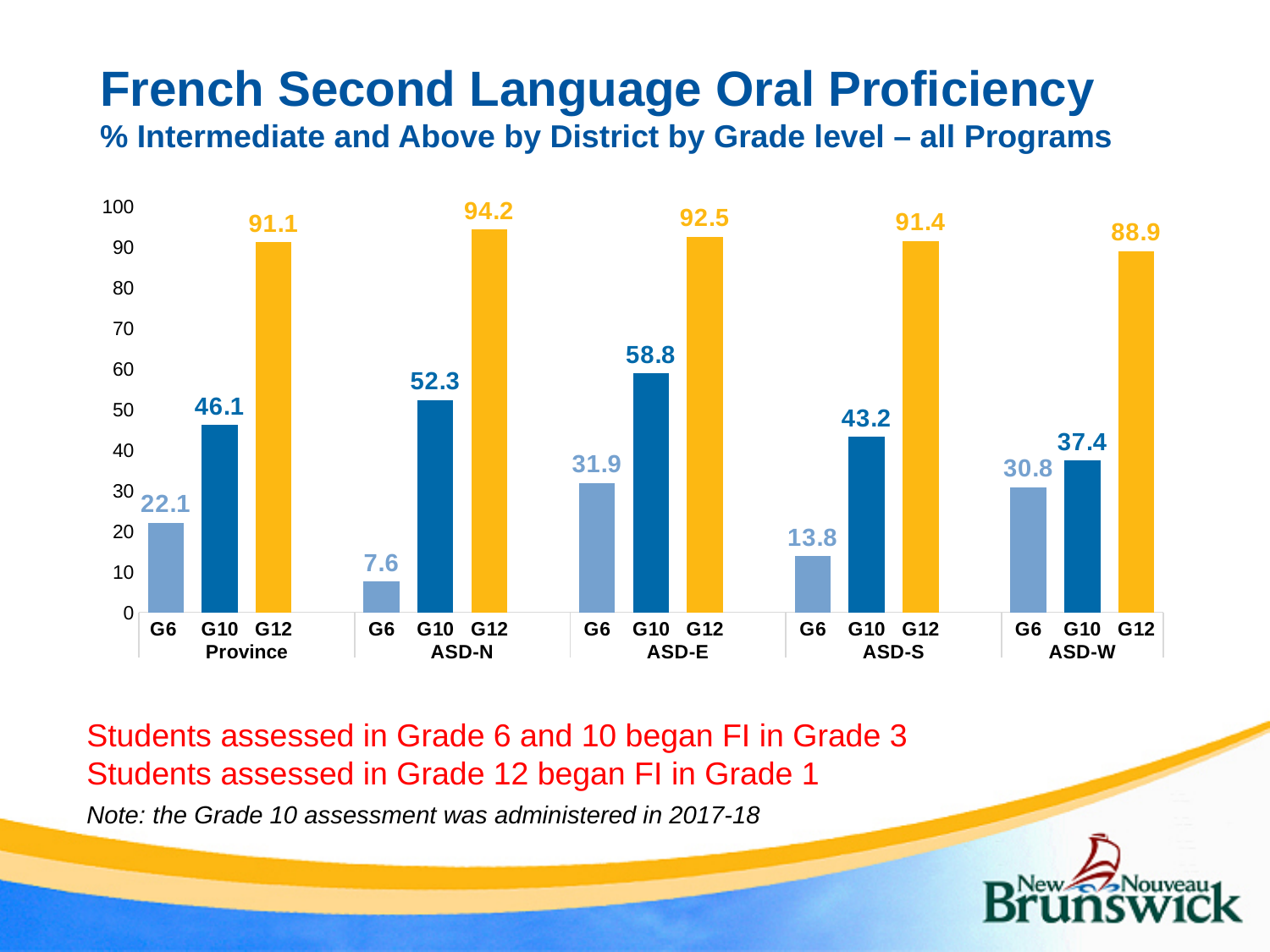
Within each district group, do the values rise or fall from G6 to G12? rise What is the value for G6 in ASD-N? 7.6 Which district has the highest G12 value? ASD-N How many district groups are shown on the x axis? 5 Which is larger, the G10 value for ASD-E or the G10 value for ASD-W? ASD-E What is the value for G12 in ASD-E? 92.5 Which district has the lowest G6 value? ASD-N Is the value for G6 in ASD-S greater or less than 20? less What kind of chart is shown on the slide? bar chart What is the title of the chart? French Second Language Oral Proficiency What is the difference between the G12 and G6 values for ASD-S? 77.6 What is the value for G10 in the Province group? 46.1